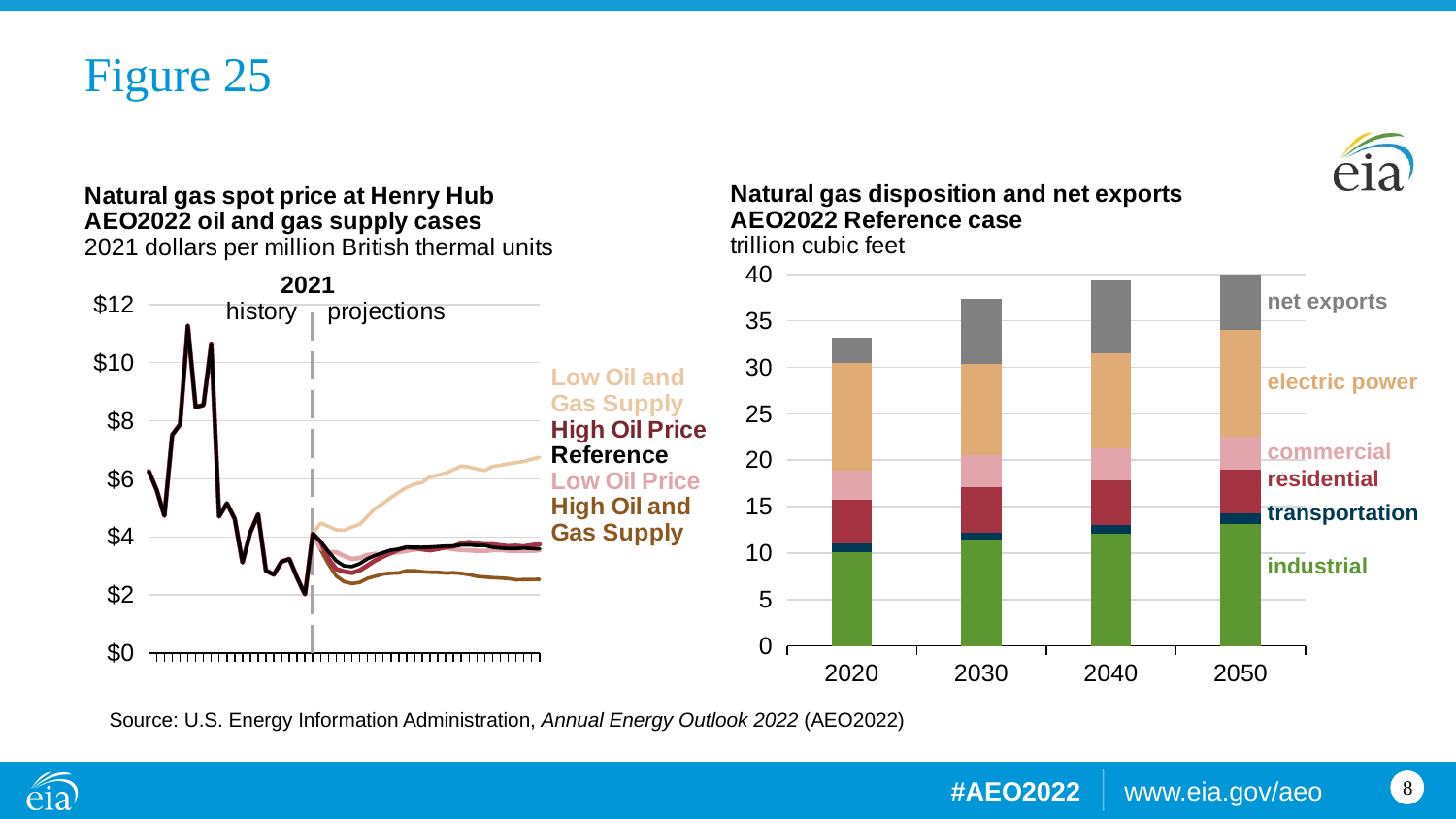
In the 'Natural gas spot price at Henry Hub' chart, what year marks the boundary between history and projections? 2021 In the 'Natural gas spot price at Henry Hub' chart, which case has the lowest price at the end of the projection period? High Oil and Gas Supply In the 'Natural gas disposition and net exports' chart, which year has the tallest total bar? 2050 In the 'Natural gas spot price at Henry Hub' chart, is the High Oil and Gas Supply price at the end of the projection greater or less than $4? less In the 'Natural gas spot price at Henry Hub' chart, which case has the highest price at the end of the projection period? Low Oil and Gas Supply In the 'Natural gas spot price at Henry Hub' chart, is the Low Oil and Gas Supply price at the end of the projection greater or less than $6? greater In the 'Natural gas disposition and net exports' chart, how many years (bars) are shown? 4 In the 'Natural gas disposition and net exports' chart, is the total for 2020 greater or less than 30 trillion cubic feet? greater What type of chart is the 'Natural gas disposition and net exports' chart on the right? stacked bar chart In the 'Natural gas disposition and net exports' chart, do the total bar heights rise or fall from 2020 to 2050? rise What type of chart is the 'Natural gas spot price at Henry Hub' chart on the left? line chart In the 'Natural gas spot price at Henry Hub' chart, how many supply/price cases (series) are labelled? 5